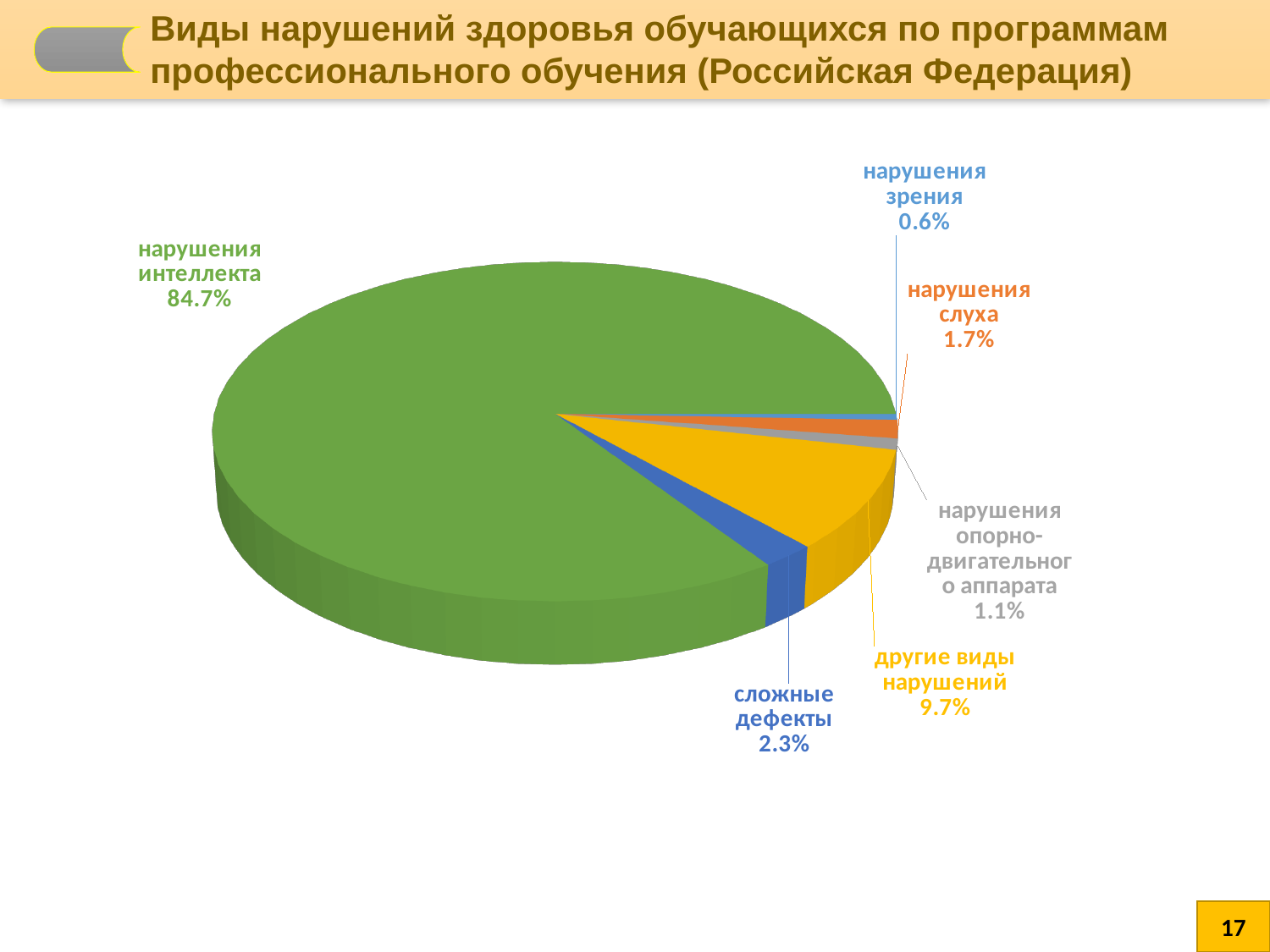
What is the value shown for "нарушения зрения"? 0.6% Which category has the smallest share of the pie? нарушения зрения What is the value shown for "сложные дефекты"? 2.3% Which category has the largest share of the pie? нарушения интеллекта How many categories are shown in the pie chart? 6 What type of chart is shown on the slide? pie chart What share of the pie is labelled "нарушения интеллекта"? 84.7% What is the value shown for "нарушения опорно-двигательного аппарата"? 1.1% Which is larger, the share for "нарушения слуха" or the share for "нарушения опорно-двигательного аппарата"? нарушения слуха What is the difference between the shares of "другие виды нарушений" and "сложные дефекты"? 7.4% What is the value shown for "другие виды нарушений"? 9.7% What is the value shown for "нарушения слуха"? 1.7%